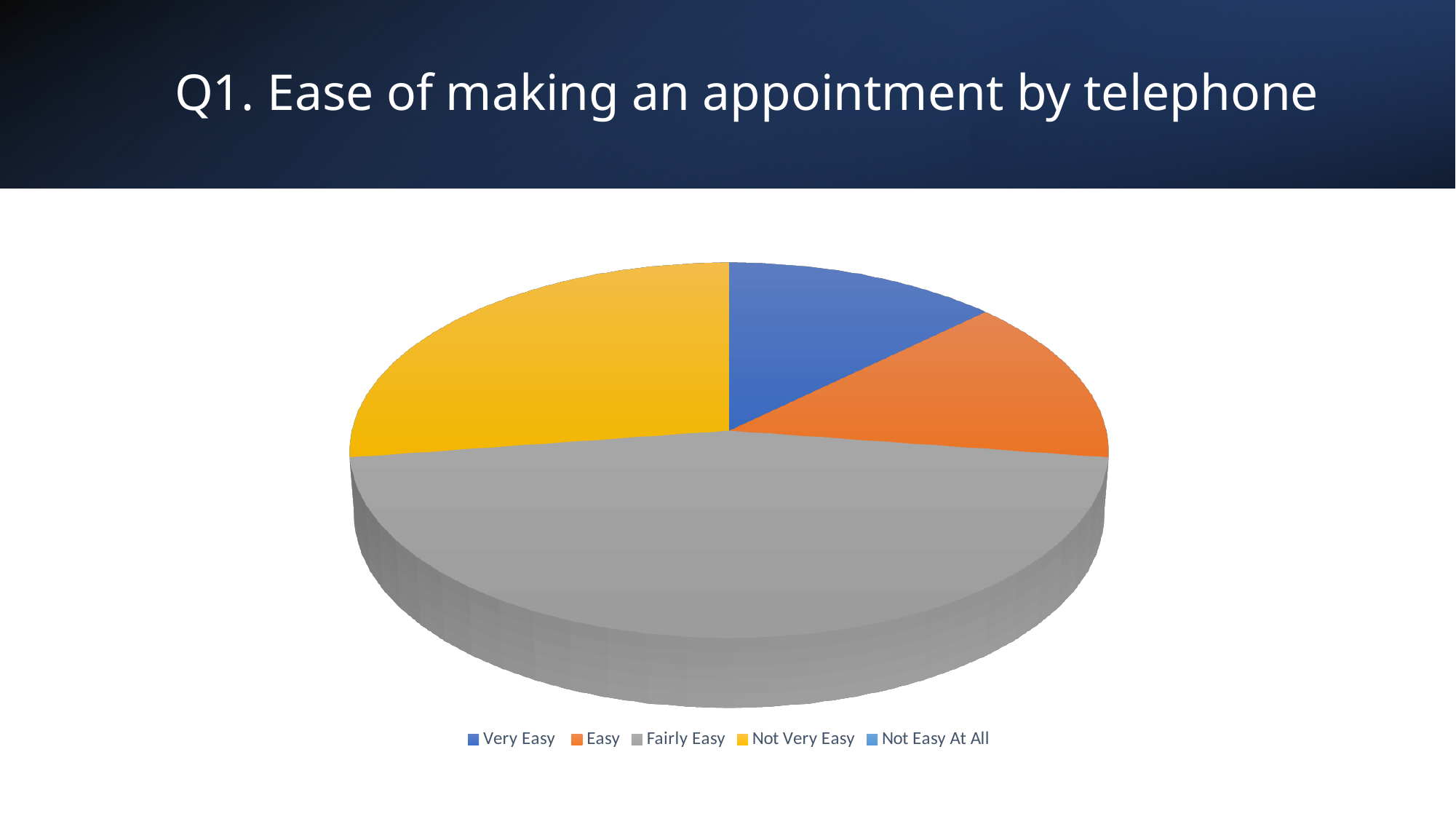
Which is larger, the slice for Not Very Easy or the slice for Easy? Not Very Easy What is the title of the chart? Q1. Ease of making an appointment by telephone Which category is shown in yellow? Not Very Easy What colour is the Fairly Easy slice? grey Which is larger, the slice for Fairly Easy or the slice for Not Very Easy? Fairly Easy How many categories does the legend list? 5 Which is larger, the slice for Fairly Easy or the slice for Very Easy? Fairly Easy Which category has the largest slice of the pie? Fairly Easy What kind of chart is shown on the slide? pie chart